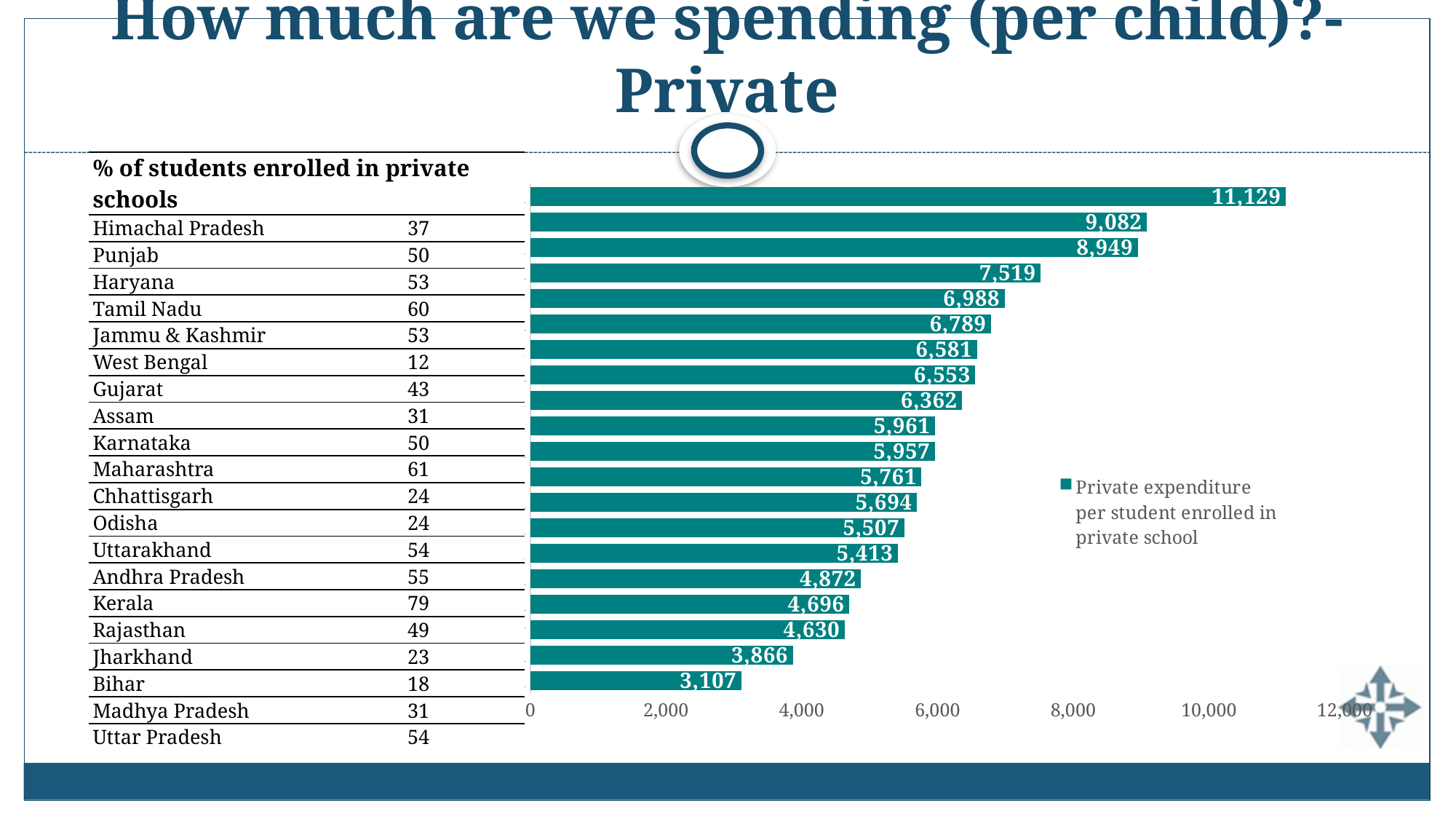
How many series does the chart's legend list? 1 What kind of chart is shown on the slide? bar chart Do the bar values increase or decrease going from the top of the chart to the bottom? decrease What is the value of the second bar from the top of the chart? 9,082 What is the difference between the top two bars in the chart (11,129 and 9,082)? 2,047 What is the highest value shown in the chart? 11,129 What is the difference between the highest and lowest values in the chart? 8,022 What is the value of the second bar from the bottom of the chart? 3,866 What is the maximum value shown on the chart's horizontal axis? 12,000 How many bars does the chart contain? 20 What is the legend entry for the series plotted in the chart? Private expenditure per student enrolled in private school What is the lowest value shown in the chart? 3,107